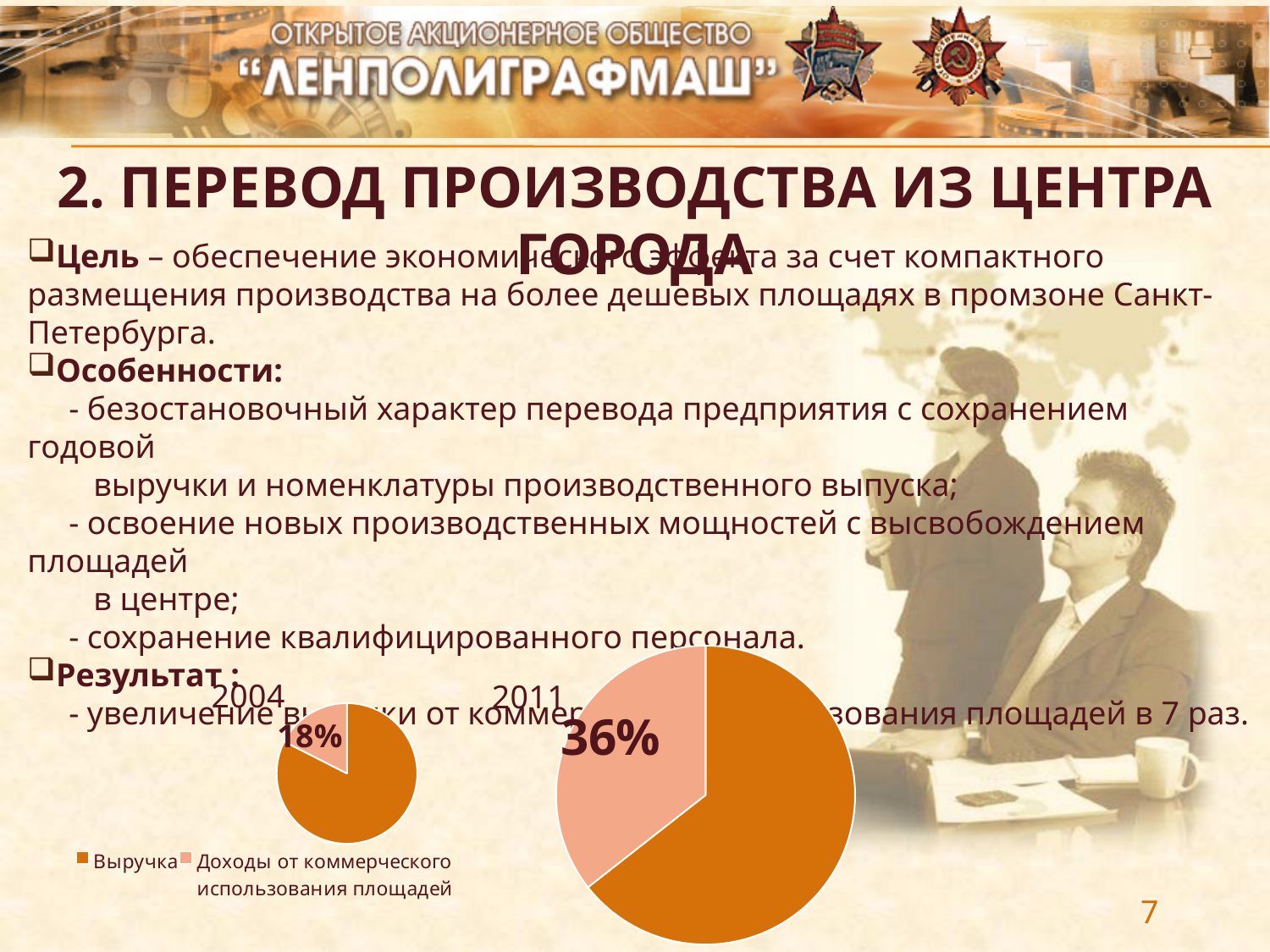
In the 2004 pie chart, what share is labelled for Доходы от коммерческого использования площадей? 18% What kind of charts are shown on the slide? Pie charts In the 2011 pie chart, what share is labelled for Доходы от коммерческого использования площадей? 36% By how many percentage points does the share of Доходы от коммерческого использования площадей in 2011 exceed that in 2004? 18 percentage points In the 2011 pie chart, which slice is the largest? Выручка In the 2011 pie chart, is the Выручка slice greater or less than half of the pie? Greater Which pie chart, 2004 or 2011, shows the larger share for Доходы от коммерческого использования площадей? 2011 Does the share of Доходы от коммерческого использования площадей rise or fall from the 2004 pie chart to the 2011 pie chart? Rises What colour is the Выручка slice in the pie charts? Orange In the 2004 pie chart, which slice is the smallest? Доходы от коммерческого использования площадей How many slices does the 2011 pie chart have? 2 How many series does the legend list for the pie charts? 2